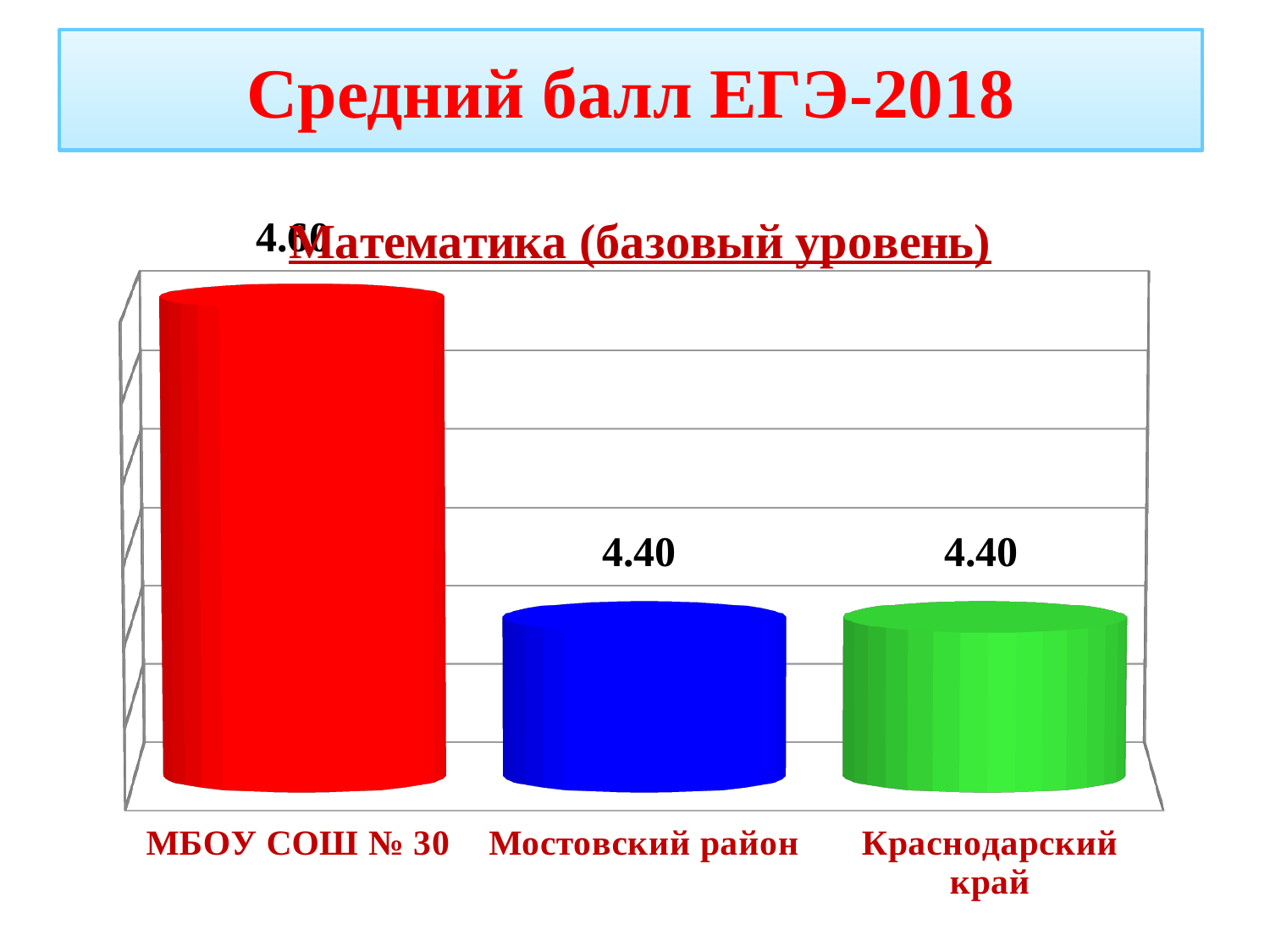
What is the value for Мостовский район? 4.40 What colour is the bar for Мостовский район? Blue What is the value for Краснодарский край? 4.40 What kind of chart is shown on the slide? Bar chart What is the difference between the values for Мостовский район and Краснодарский край? 0.00 How many categories are shown in the chart? 3 What is the title of the chart? Математика (базовый уровень) Which category has the highest value? МБОУ СОШ № 30 Which is larger, the value for МБОУ СОШ № 30 or the value for Краснодарский край? МБОУ СОШ № 30 Which is larger, the value for МБОУ СОШ № 30 or the value for Мостовский район? МБОУ СОШ № 30